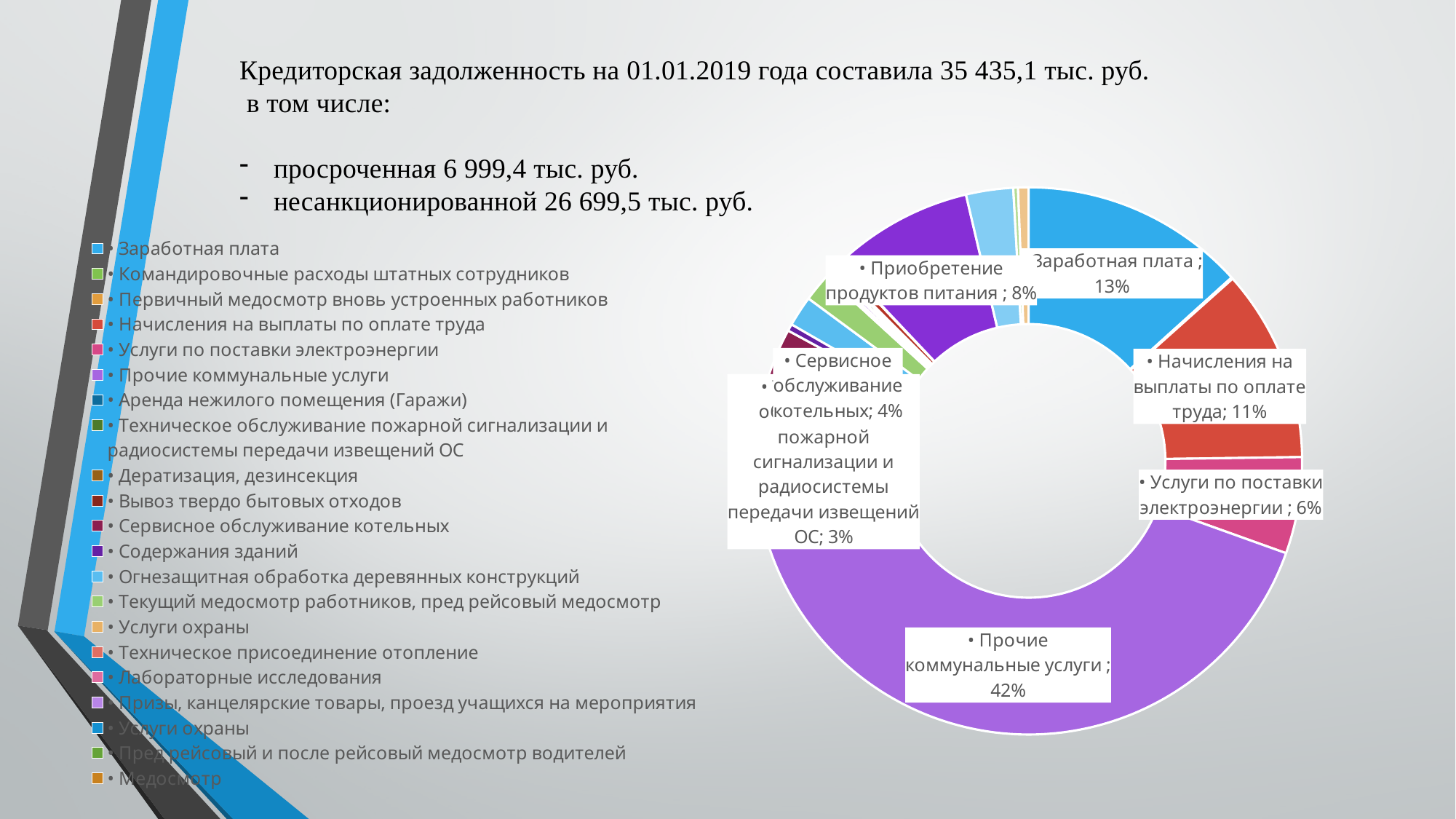
What percentage is shown for Начисления на выплаты по оплате труда? 11% What type of chart is shown on the slide? Doughnut (pie) chart What colour is the slice for Прочие коммунальные услуги? Purple What is the difference in percentage points between Прочие коммунальные услуги and Заработная плата? 29 Which category has the largest share of the chart? Прочие коммунальные услуги What share of the chart does Техническое обслуживание пожарной сигнализации и радиосистемы передачи извещений ОС represent? 3% What percentage is shown for Услуги по поставке электроэнергии? 6% What percentage is shown for Сервисное обслуживание котельных? 4% What percentage is shown for Приобретение продуктов питания? 8% Which is larger: the share for Заработная плата or the share for Начисления на выплаты по оплате труда? Заработная плата What percentage is shown for Прочие коммунальные услуги? 42% What percentage is shown for Заработная плата? 13%